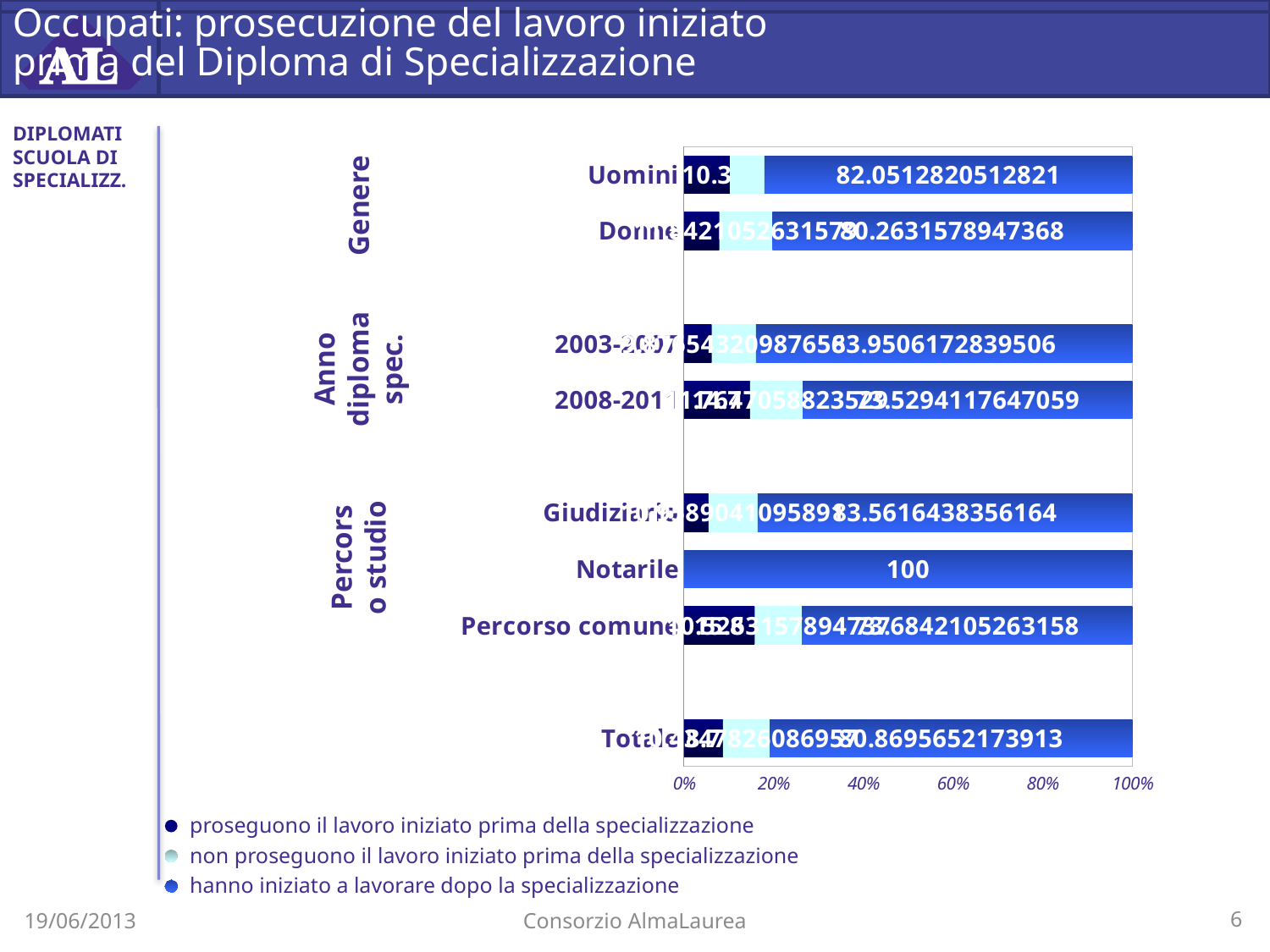
What is the first entry listed in the chart legend? proseguono il lavoro iniziato prima della specializzazione What is the value for Uomini in the series 'proseguono il lavoro iniziato prima della specializzazione'? 10.3 How many categories are plotted on the y axis of the chart? 8 What kind of chart is shown on the slide? bar chart What is the value for Totale in the series 'hanno iniziato a lavorare dopo la specializzazione'? 80.8695652173913 Which category has the lowest value in the series 'hanno iniziato a lavorare dopo la specializzazione'? 2008-2011 What is the value for Notarile in the series 'hanno iniziato a lavorare dopo la specializzazione'? 100 What is the value for Uomini in the series 'hanno iniziato a lavorare dopo la specializzazione'? 82.0512820512821 Which category has the highest value in the series 'hanno iniziato a lavorare dopo la specializzazione'? Notarile In the series 'hanno iniziato a lavorare dopo la specializzazione', which is larger: Uomini or Donne? Uomini How many series does the legend list? 3 Is the value for Percorso comune in the series 'hanno iniziato a lavorare dopo la specializzazione' greater or less than 80%? less